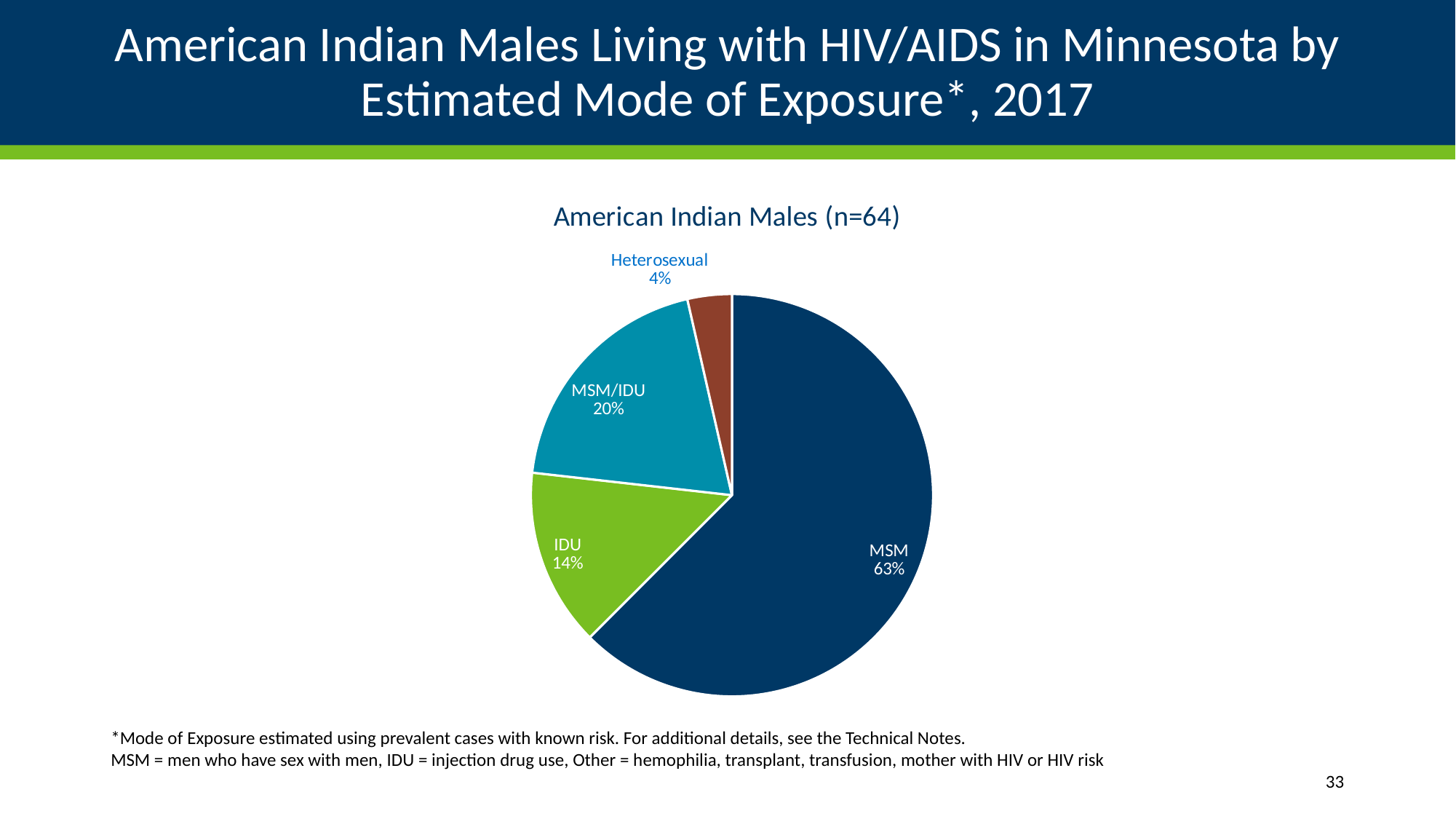
How many slices does the pie chart have? 4 What is the difference in percentage points between MSM and MSM/IDU? 43 What is the sample size (n) given in the chart title? 64 What percentage is shown for MSM/IDU? 20% What percentage is shown for IDU? 14% Which mode of exposure has the largest slice of the pie? MSM What kind of chart is shown on the slide? pie chart Which mode of exposure has the smallest slice of the pie? Heterosexual What share of the pie does MSM account for? 63% What percentage is shown for Heterosexual? 4% What is the title shown above the pie chart? American Indian Males (n=64) Which is larger, the share for IDU or the share for MSM/IDU? MSM/IDU